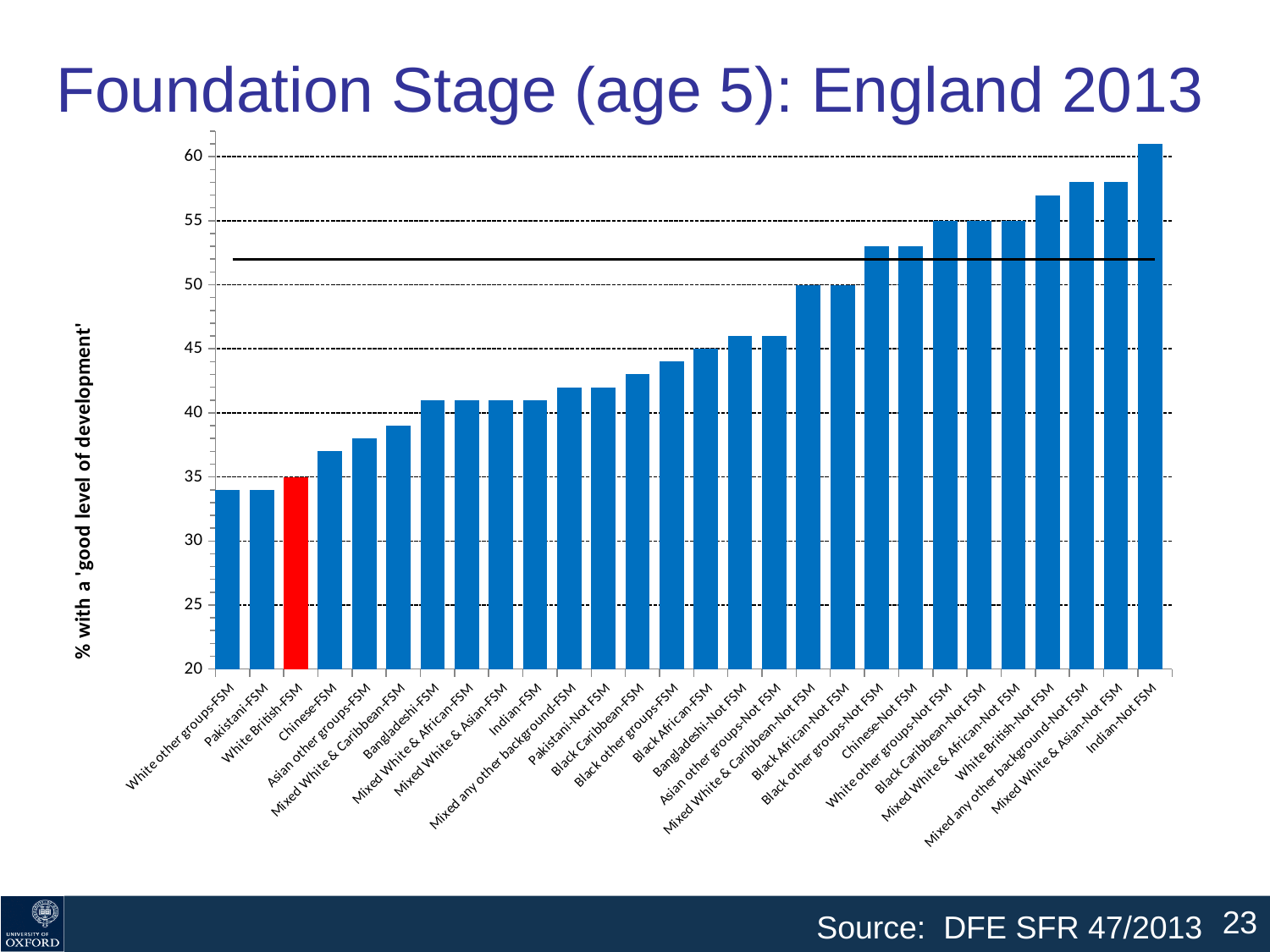
What type of chart is shown on the slide? Bar chart Which category is shown with a red bar? White British-FSM Do the bar values rise or fall moving from left to right along the x axis? Rise What is the label on the y axis? % with a 'good level of development' What is the value for Black African-FSM? 45 Is the value for Indian-Not FSM greater or less than 60? greater Which category has the highest value in the chart? Indian-Not FSM Is the value for Chinese-FSM greater or less than 40? less How many bars (ethnic group / FSM categories) are plotted in the chart? 28 Which is larger, the value for Bangladeshi-FSM or the value for Black Caribbean-FSM? Black Caribbean-FSM What is the value for Black African-Not FSM? 50 What is the value for White British-FSM? 35